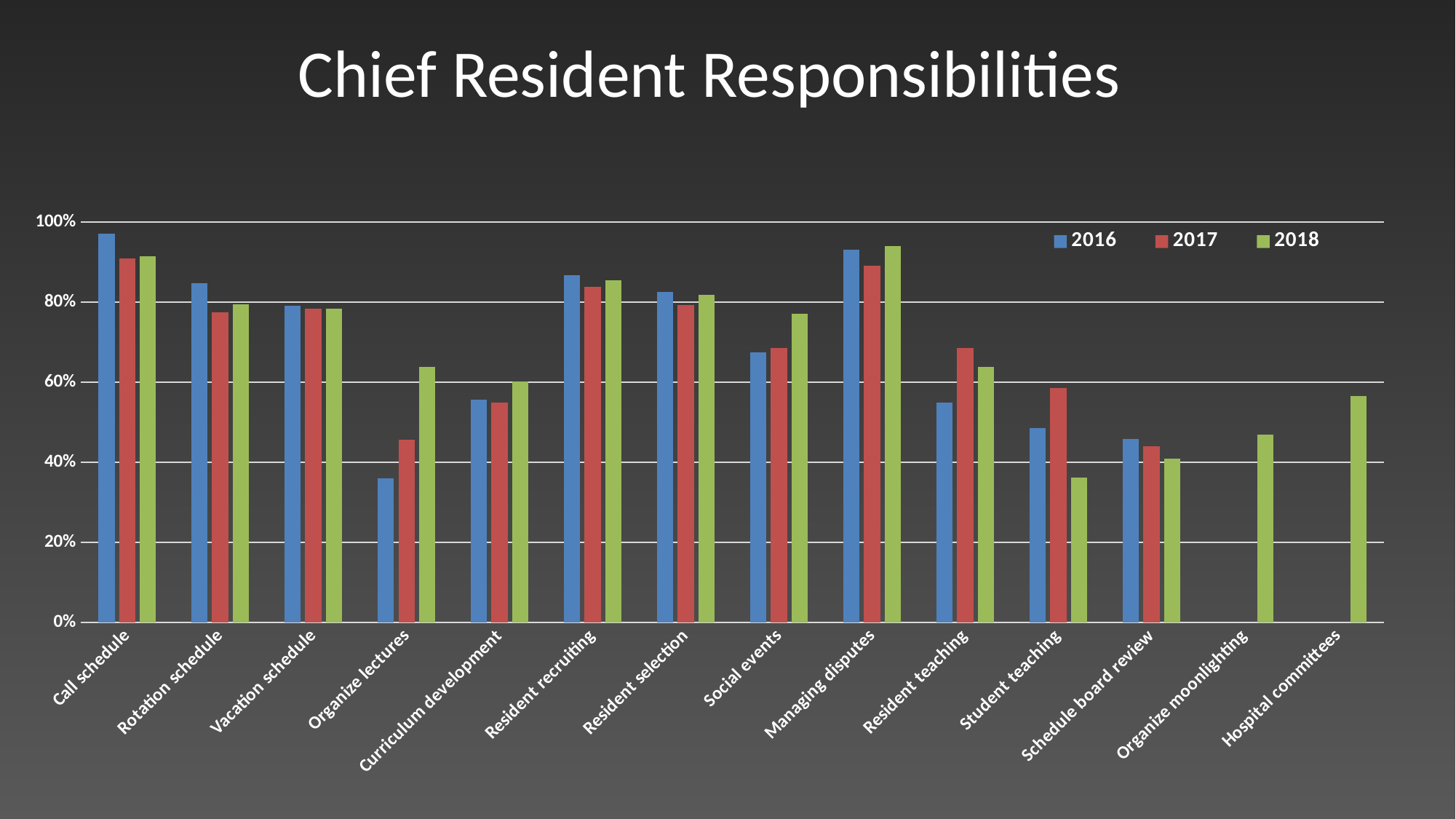
Which series is the only one with a bar for Hospital committees? 2018 Is the 2016 value for Call schedule greater or less than 80%? greater For Student teaching, which is larger: the 2017 value or the 2018 value? 2017 Is the 2018 value for Organize moonlighting greater or less than 40%? greater Is the 2016 value for Organize lectures greater or less than 40%? less What kind of chart is shown on the slide? bar chart Which category has the lowest value for 2016? Organize lectures How many responsibility categories are shown on the x axis? 14 Which category has the highest value for 2016? Call schedule For Organize lectures, which is larger: the 2016 value or the 2018 value? 2018 How many series does the legend list? 3